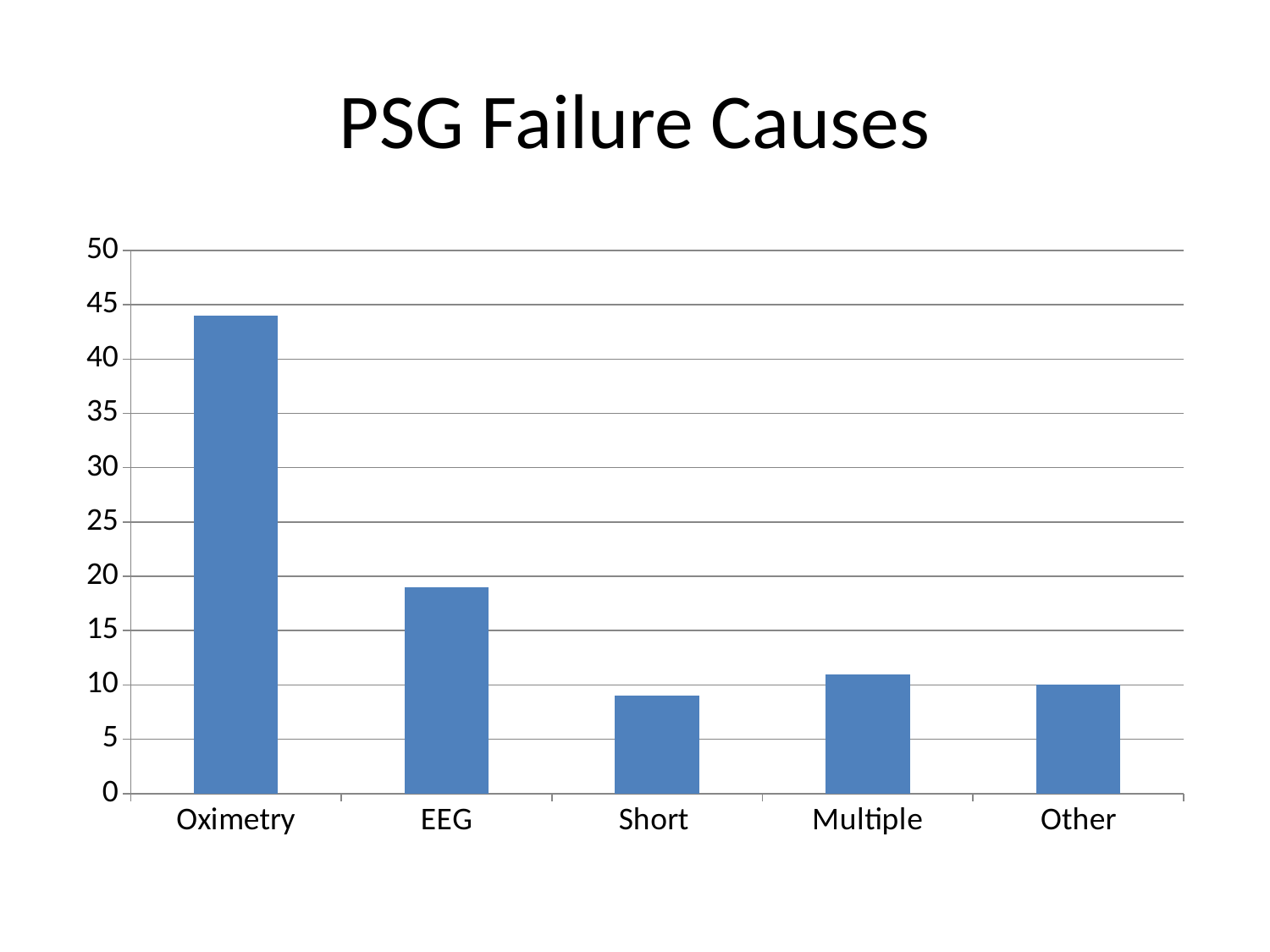
Which category has the highest value? Oximetry What is the title of the chart? PSG Failure Causes Is the value for EEG greater or less than 15? greater How many categories are shown on the x axis? 5 Is the value for Short greater or less than 10? less Which is larger, the value for Oximetry or the value for Multiple? Oximetry Is the value for Multiple greater or less than 15? less Which is larger, the value for EEG or the value for Short? EEG What type of chart is shown on the slide? bar chart